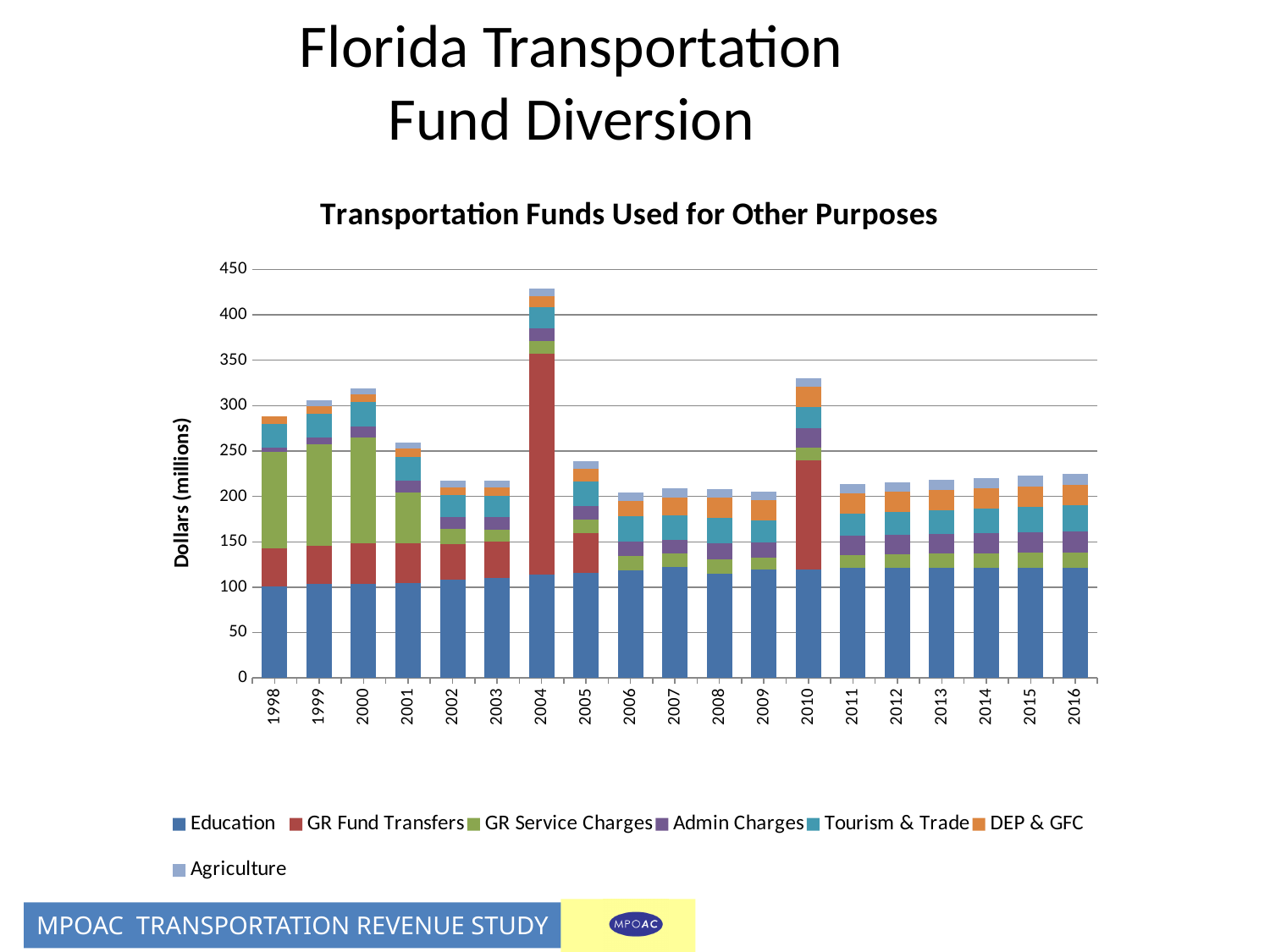
Which year has the larger total bar, 2004 or 2010? 2004 Is the total bar for 2006 greater or less than 250? less Which year has the highest total bar in the chart? 2004 Which year has the larger total bar, 2000 or 2001? 2000 How many years are shown along the x axis of the chart? 19 Which series forms the bottom segment of each stacked bar? Education Is the total bar for 2004 greater or less than 400? greater Is the total bar for 1998 greater or less than 300? less What kind of chart is shown on the slide? Stacked bar chart How many series does the chart's legend list? 7 What is the title of the chart? Transportation Funds Used for Other Purposes